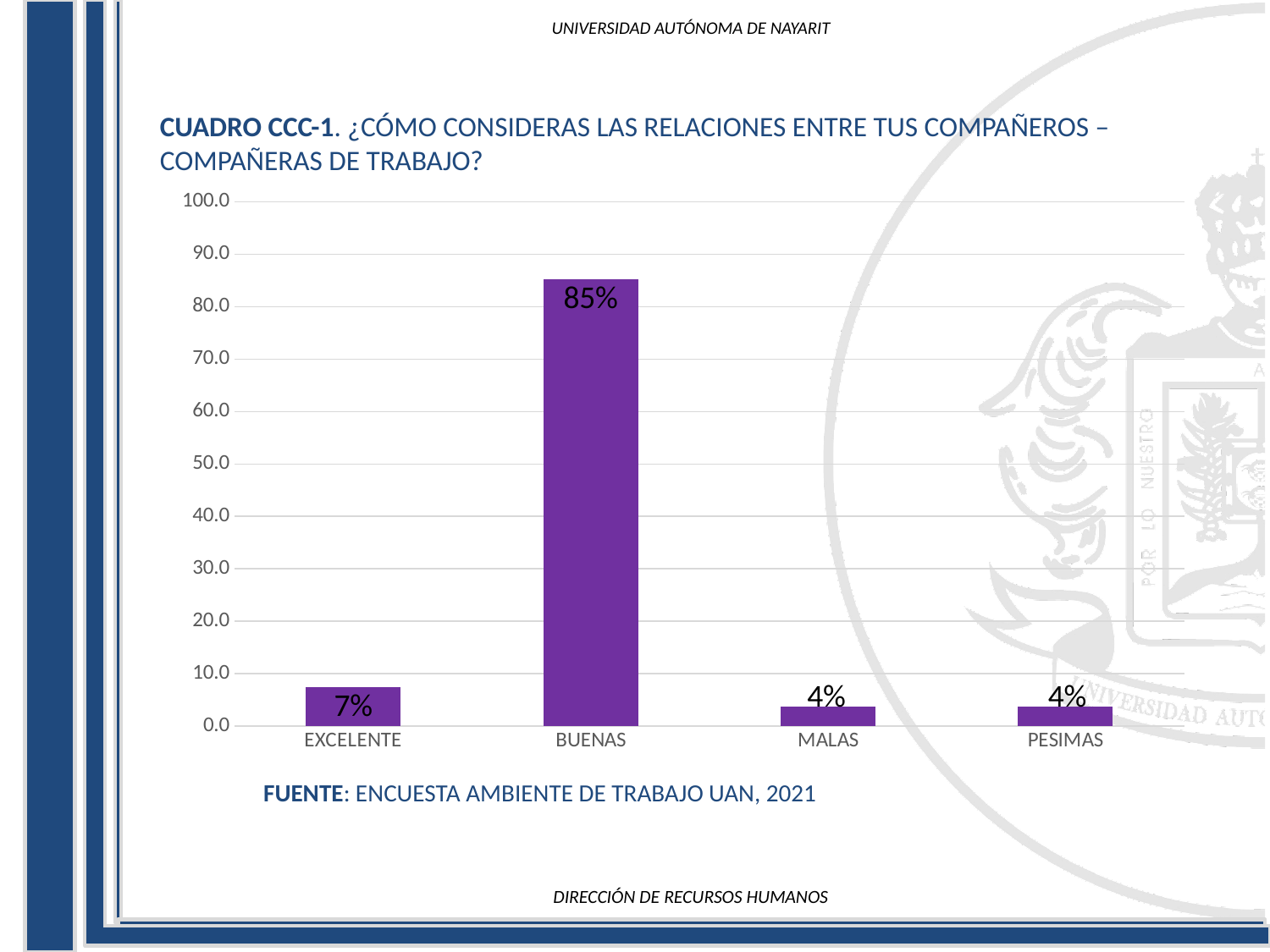
What is the value for EXCELENTE? 7% Is the value for BUENAS greater or less than 80.0? greater Which is larger, the value for EXCELENTE or the value for PESIMAS? EXCELENTE What kind of chart is shown on the slide? bar chart What is the value for BUENAS? 85% What is the source cited below the chart? ENCUESTA AMBIENTE DE TRABAJO UAN, 2021 How many categories are shown on the x axis? 4 Is the value for EXCELENTE greater or less than 10.0? less What colour are the bars in the chart? purple What is the value for MALAS? 4% Which category has the highest value? BUENAS What is the difference between the values for BUENAS and EXCELENTE? 78%